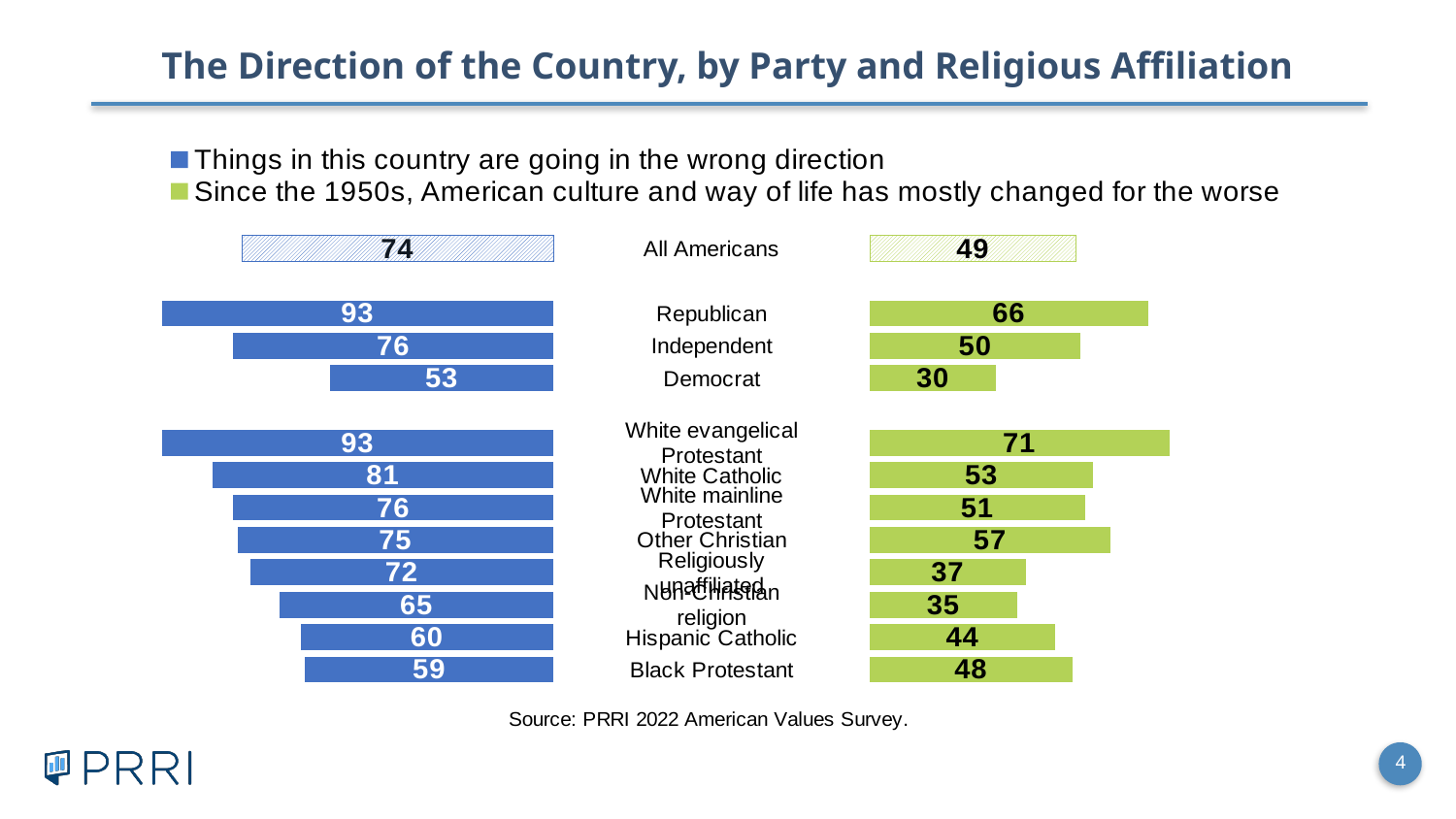
How many series does the legend list? 2 For All Americans, what is the difference between the 'wrong direction' value and the 'changed for the worse' value? 25 What type of chart is shown on the slide? Bar chart What is the difference between Republicans and Democrats on the 'Things in this country are going in the wrong direction' series? 40 What percentage of Republicans say things in this country are going in the wrong direction? 93 What percentage of Democrats say that since the 1950s, American culture and way of life has mostly changed for the worse? 30 What is the value for Black Protestants on the 'Things in this country are going in the wrong direction' series? 59 What is the value for Independents on the 'Since the 1950s, American culture and way of life has mostly changed for the worse' series? 50 Among the party groups (Republican, Independent, Democrat), which has the highest value for 'Since the 1950s, American culture and way of life has mostly changed for the worse'? Republican Among the party groups (Republican, Independent, Democrat), which has the lowest value for 'Things in this country are going in the wrong direction'? Democrat Which is larger: the 'changed for the worse' value for Hispanic Catholics or for Black Protestants? Black Protestant What is the value for All Americans on the 'Things in this country are going in the wrong direction' series? 74